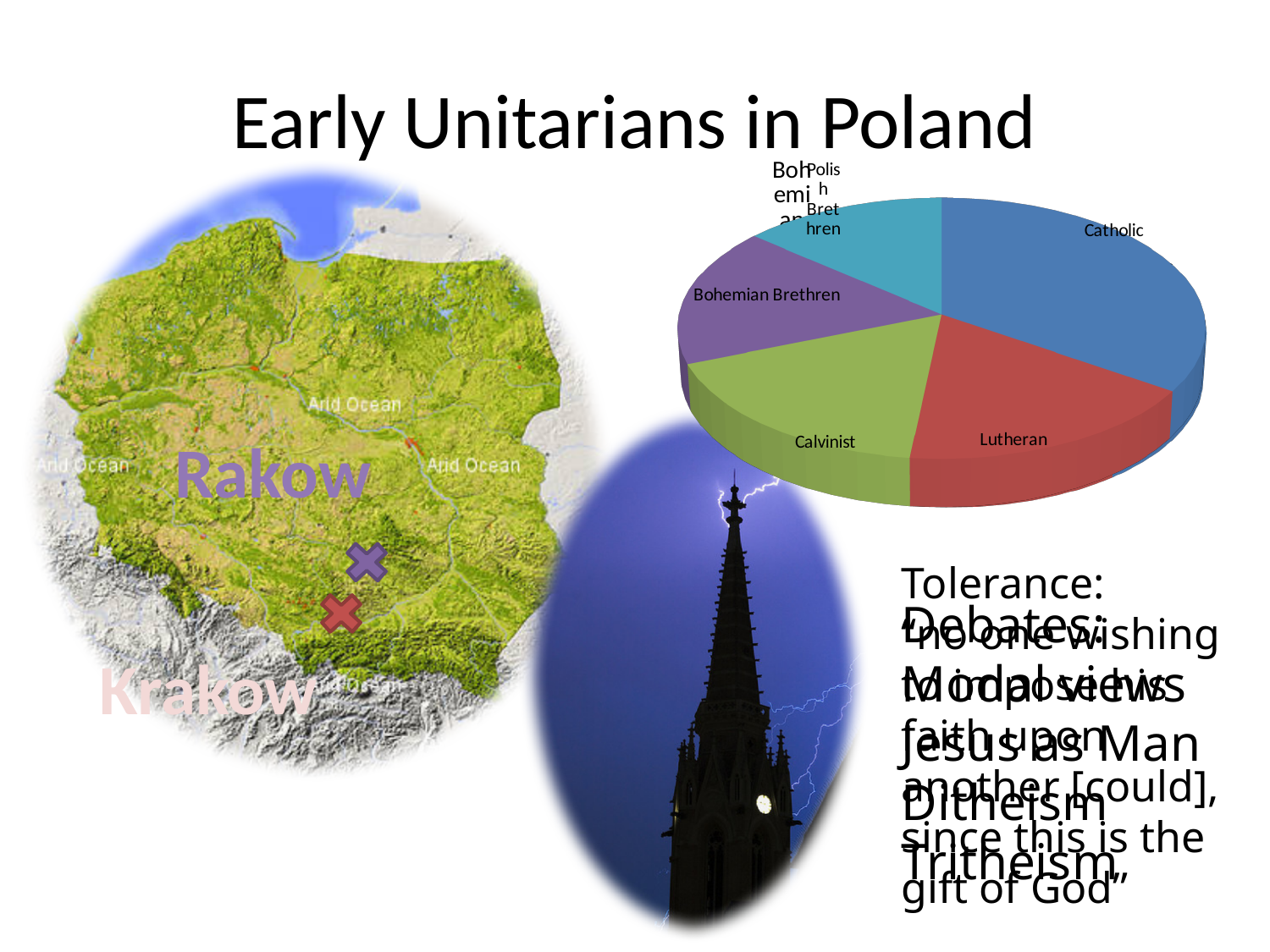
Which category has the largest slice in the pie chart? Catholic What colour is the Calvinist slice in the pie chart? green What colour is the Catholic slice in the pie chart? blue In the pie chart, which is larger: the Catholic slice or the Calvinist slice? Catholic How many slices does the pie chart have? 5 In the pie chart, which is larger: the Catholic slice or the Bohemian Brethren slice? Catholic What kind of chart is shown on the slide? pie chart